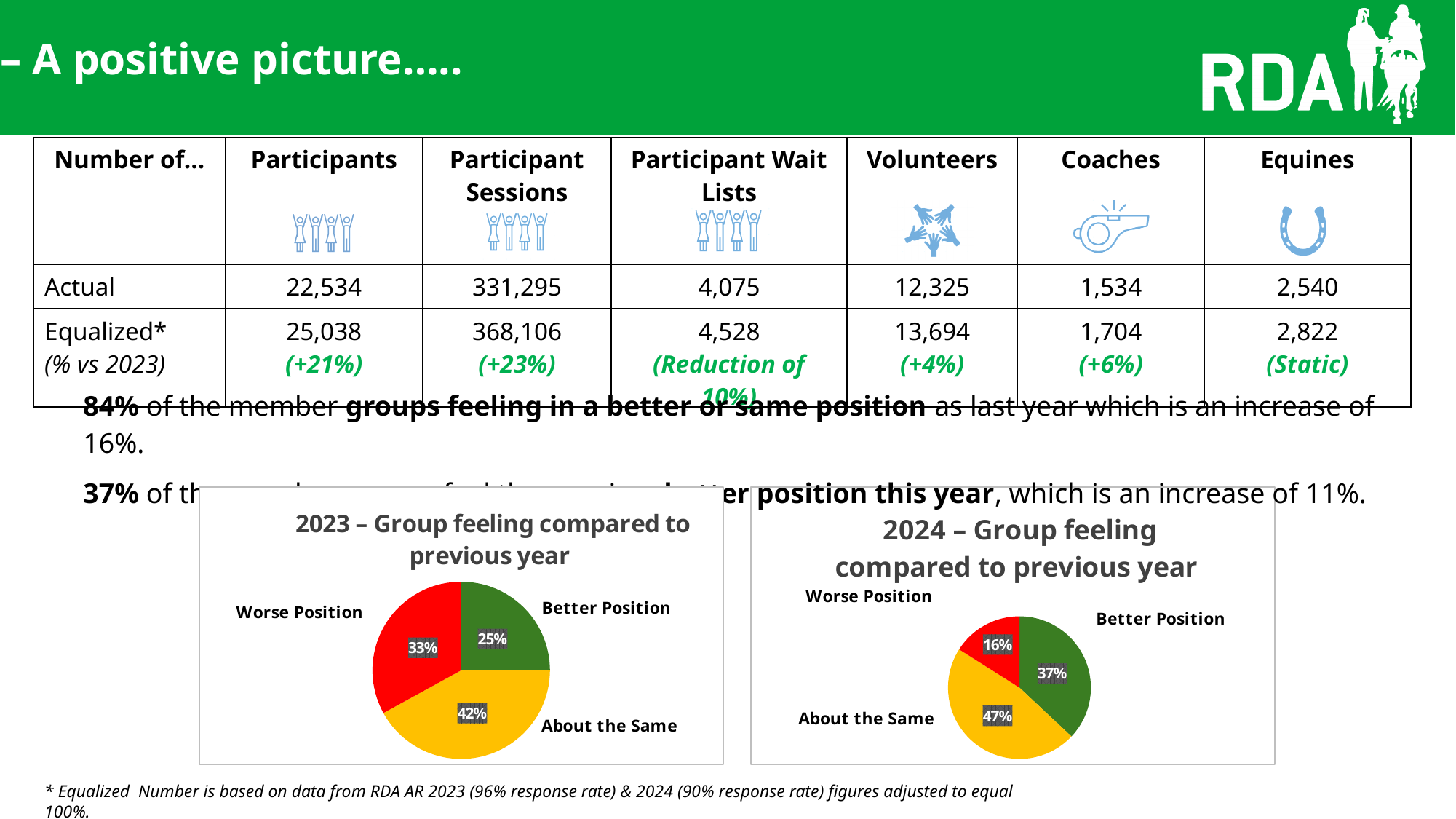
What is the difference between the 'Better Position' share in the 2024 chart and the 'Better Position' share in the 2023 chart? 12% In the '2024 – Group feeling compared to previous year' chart, which is larger: 'Better Position' or 'Worse Position'? Better Position How many slices does the '2023 – Group feeling compared to previous year' chart have? 3 In the '2024 – Group feeling compared to previous year' chart, which category has the smallest slice? Worse Position In the '2024 – Group feeling compared to previous year' chart, what colour is the 'About the Same' slice? Yellow What type of chart is the '2024 – Group feeling compared to previous year' chart? Pie chart In the '2023 – Group feeling compared to previous year' chart, what share is 'Better Position'? 25% In the '2023 – Group feeling compared to previous year' chart, which category has the smallest slice? Better Position In the '2023 – Group feeling compared to previous year' chart, which category has the largest slice? About the Same In the '2023 – Group feeling compared to previous year' chart, what share is 'Worse Position'? 33% In the '2024 – Group feeling compared to previous year' chart, what share is 'Worse Position'? 16% In the '2024 – Group feeling compared to previous year' chart, what share is 'About the Same'? 47%